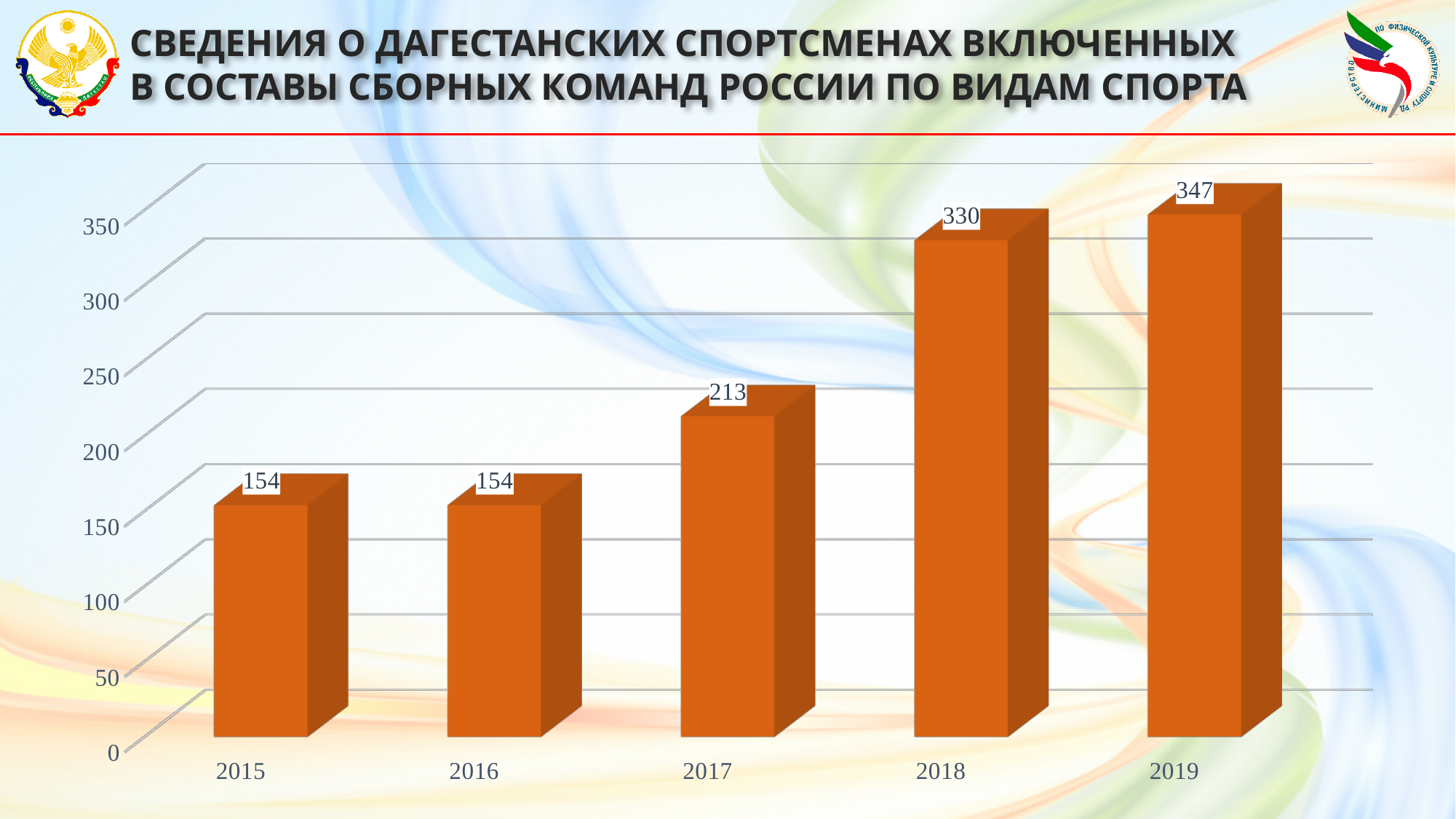
What is the difference between the values for 2017 and 2016? 59 Which two years have the same value? 2015 and 2016 Do the values generally rise or fall from 2015 to 2019? rise Which is larger, the value for 2018 or the value for 2017? 2018 How many years are shown on the x axis? 5 What is the value for 2017? 213 What is the value for 2015? 154 What is the value for 2019? 347 Which year has the highest value? 2019 What is the difference between the values for 2019 and 2018? 17 What kind of chart is shown on the slide? bar chart Is the value for 2018 greater or less than 300? greater